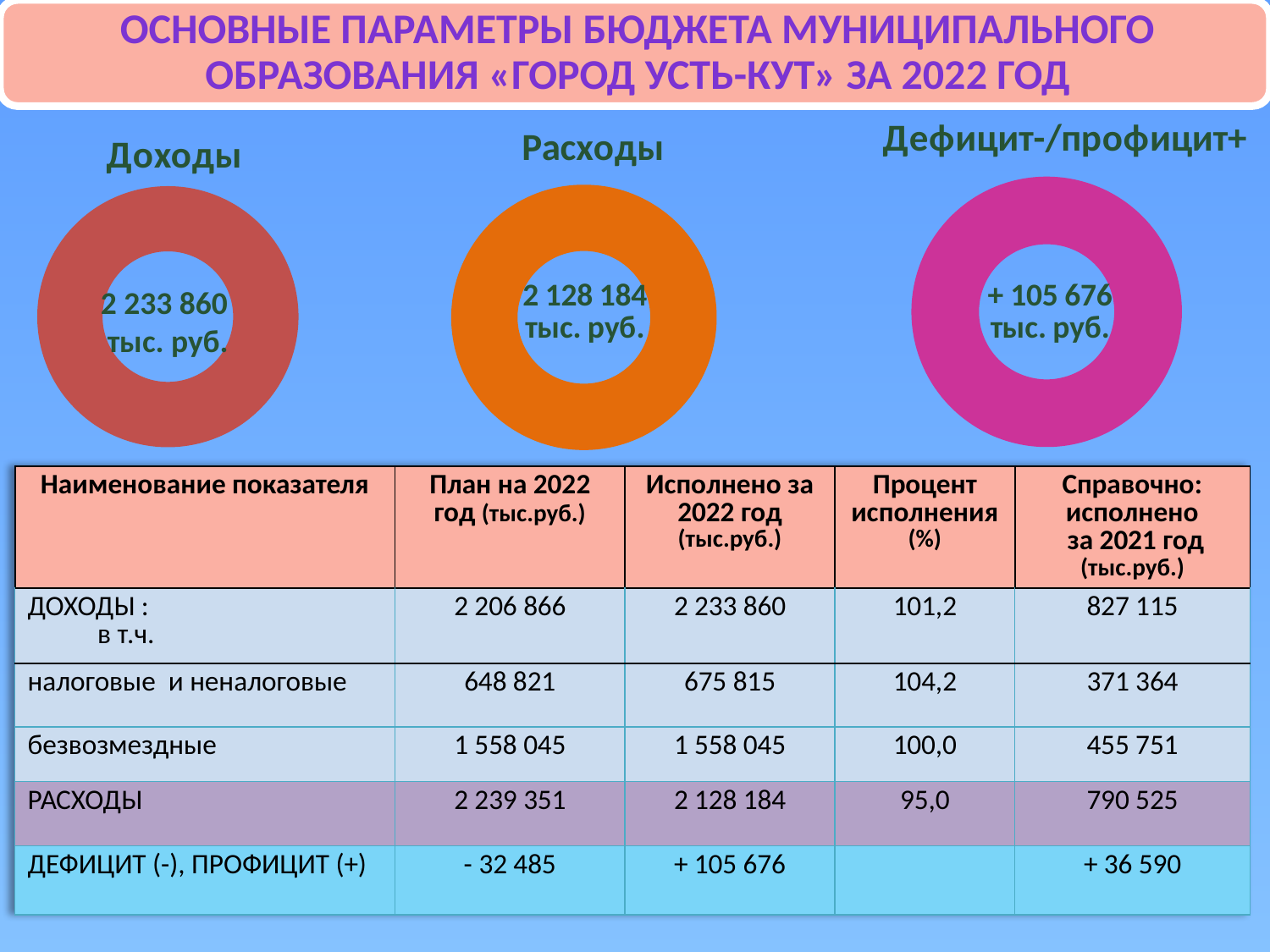
Is the value shown in the "Расходы" chart greater or less than 2 200 000 тыс. руб.? less What value is shown in the centre of the "Доходы" doughnut chart? 2 233 860 тыс. руб. Which of the three doughnut charts shows the highest value? Доходы Which is larger, the value in the "Доходы" chart or the value in the "Расходы" chart? Доходы Which of the three doughnut charts shows the lowest value? Дефицит-/профицит+ How many doughnut charts are shown on the slide? 3 What value is shown in the centre of the "Дефицит-/профицит+" doughnut chart? + 105 676 тыс. руб. What colour is the "Дефицит-/профицит+" doughnut chart? Magenta (pink) What colour is the "Расходы" doughnut chart? Orange What kind of chart is used to display "Доходы", "Расходы" and "Дефицит-/профицит+"? Doughnut chart What value is shown in the centre of the "Расходы" doughnut chart? 2 128 184 тыс. руб. What is the difference between the value in the "Доходы" chart and the value in the "Расходы" chart? 105 676 тыс. руб.